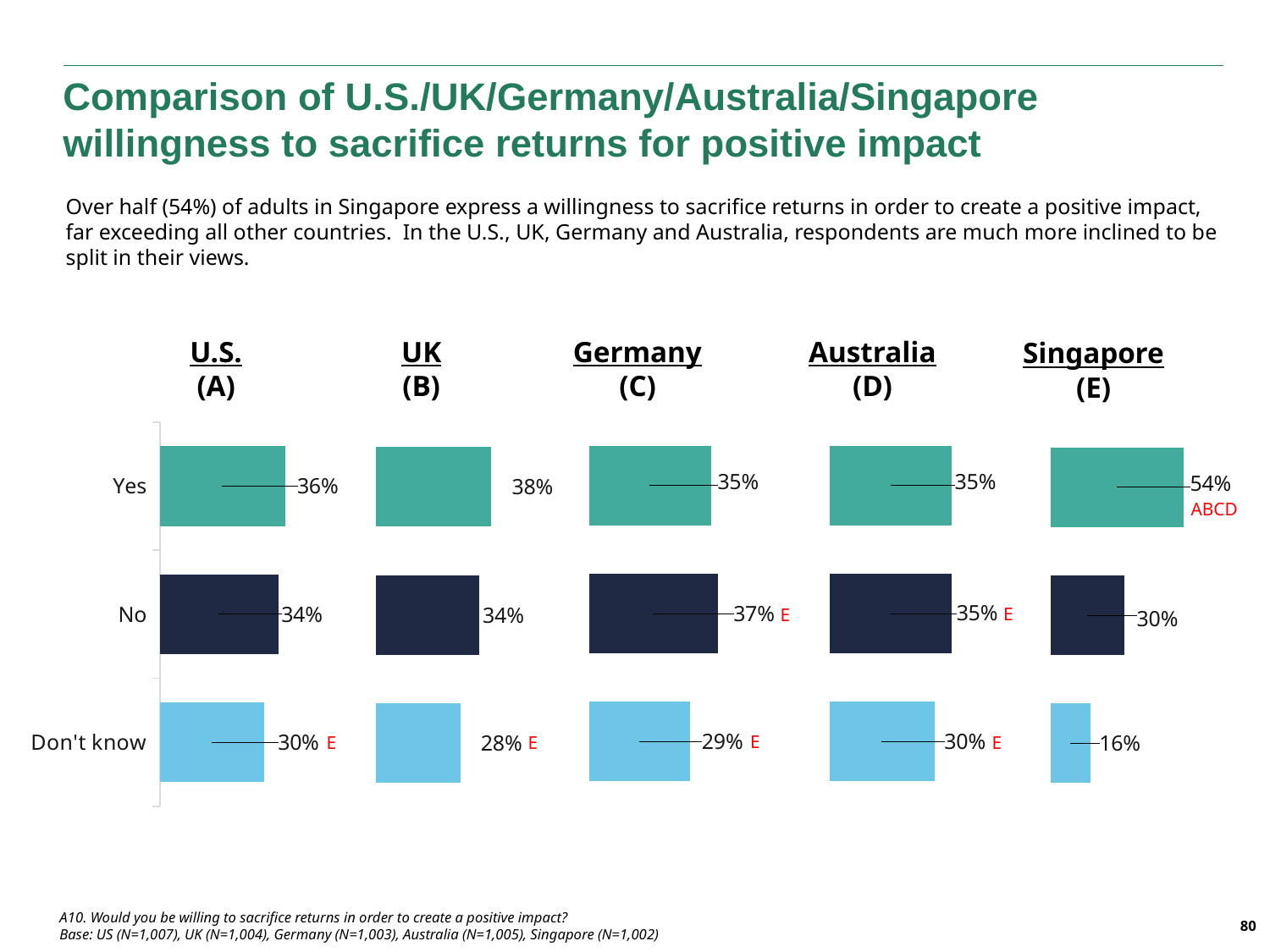
In the Australia (D) chart, what percentage answered Yes? 35% In the Germany (C) chart, what percentage answered No? 37% In the Singapore (E) chart, what is the difference between the Yes and No percentages? 24 percentage points In the Singapore (E) chart, what percentage answered Yes? 54% In the Germany (C) chart, which is larger, the Yes percentage or the No percentage? No In the U.S. (A) chart, which response has the highest percentage? Yes How many country charts are shown on the slide? 5 What type of chart is used to show the responses for each country? Bar chart In the U.S. (A) chart, what is the difference between the Yes and Don't know percentages? 6 percentage points How many response categories are shown in each country's chart? 3 In the UK (B) chart, what percentage answered Don't know? 28% In the Singapore (E) chart, which response has the lowest percentage? Don't know